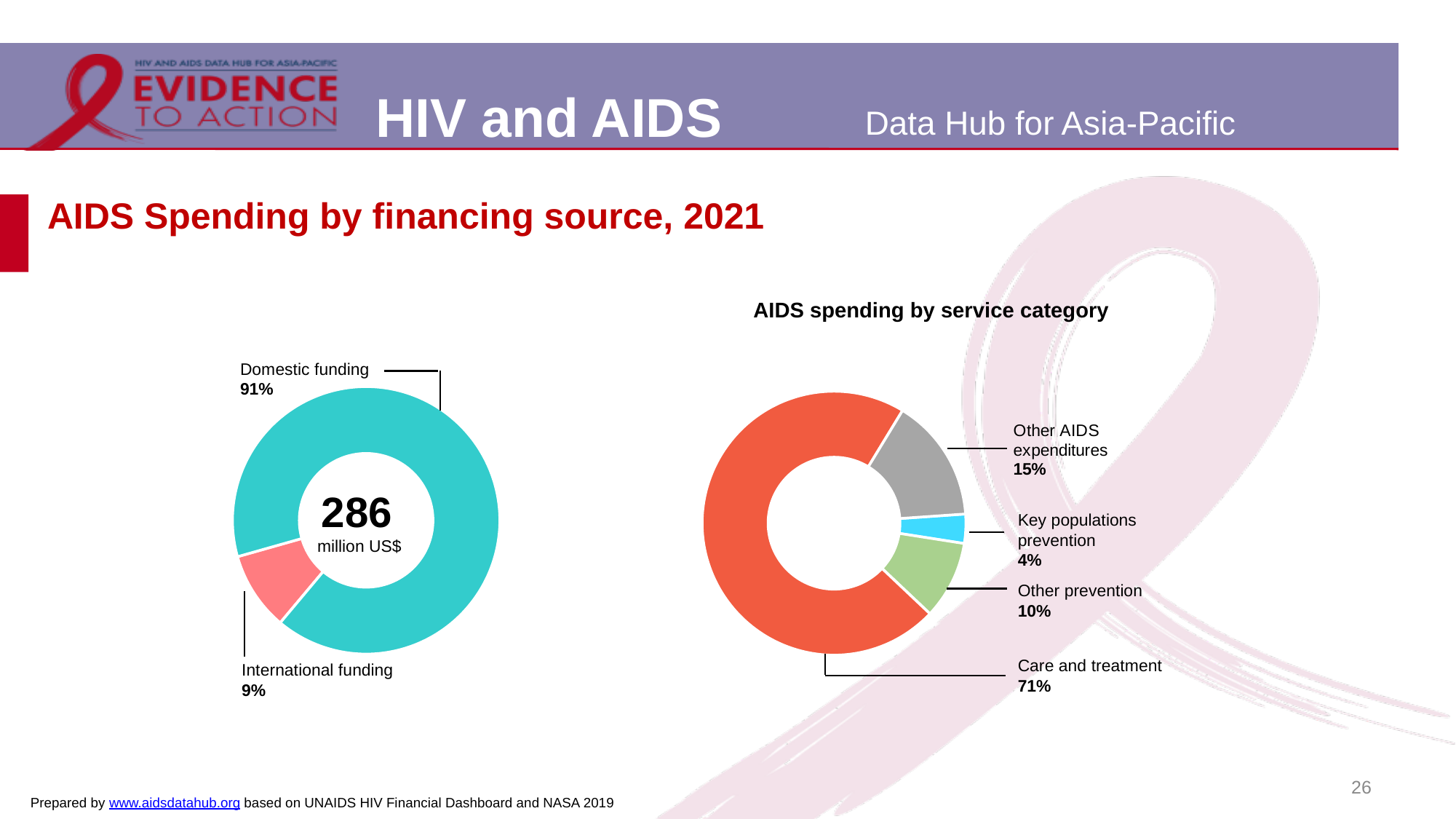
In the AIDS spending by service category chart, what share is Other AIDS expenditures? 15% In the AIDS Spending by financing source chart, what is the difference in percentage points between Domestic funding and International funding? 82 percentage points In the AIDS spending by service category chart, how many service categories are shown? 4 In the AIDS spending by service category chart, which is larger: Other prevention or Other AIDS expenditures? Other AIDS expenditures What kind of chart is the AIDS spending by service category chart? Donut (pie) chart In the AIDS spending by service category chart, what share is Key populations prevention? 4% In the AIDS spending by service category chart, which category has the smallest share? Key populations prevention In the AIDS Spending by financing source chart, what total amount is shown in the centre of the donut? 286 million US$ In the AIDS spending by service category chart, what share is Care and treatment? 71% In the AIDS Spending by financing source chart, what share is International funding? 9% In the AIDS spending by service category chart, which category has the largest share? Care and treatment In the AIDS Spending by financing source chart, what share is Domestic funding? 91%